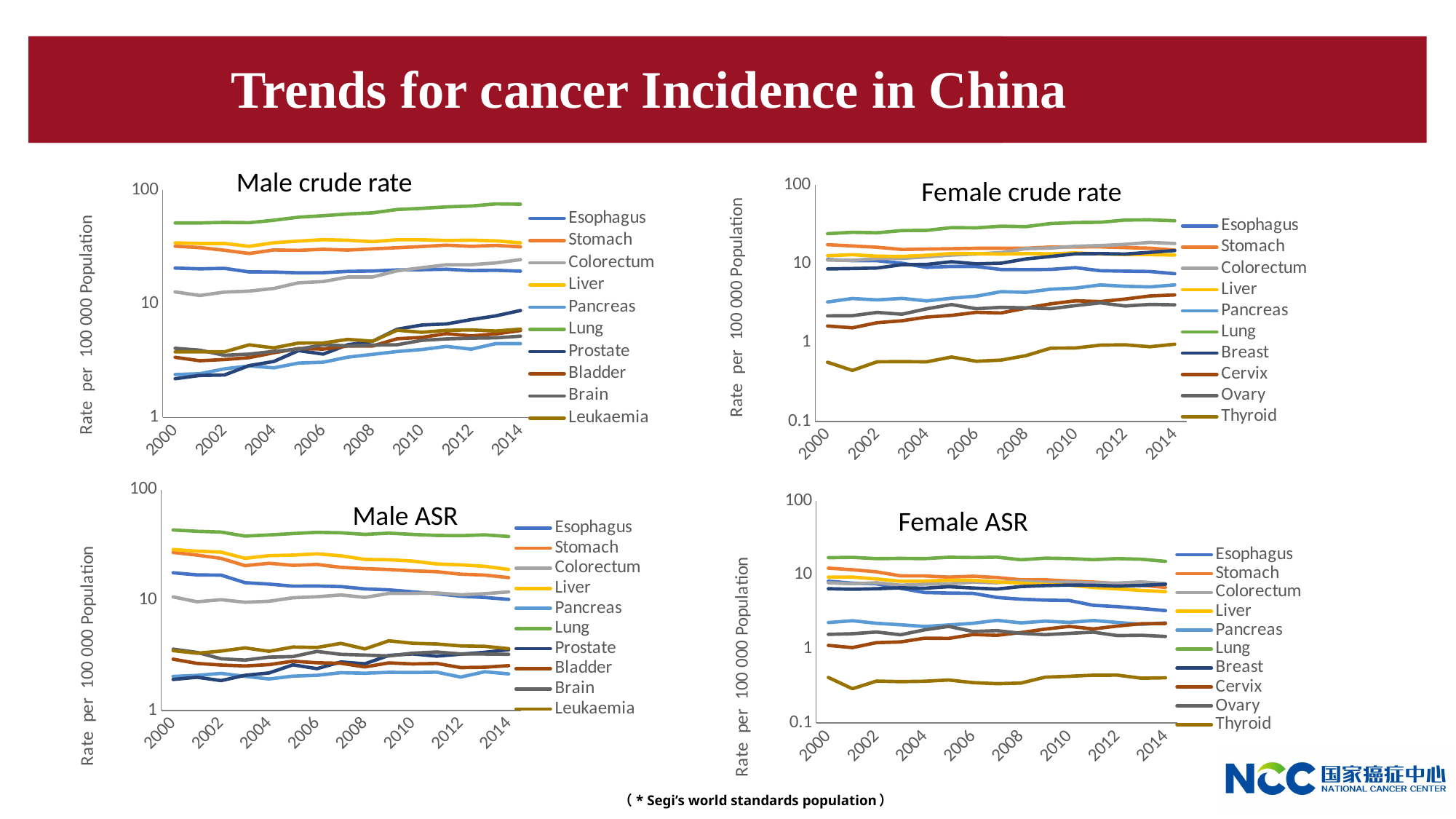
What is the y-axis label on the 'Female ASR' chart? Rate per 100 000 Population In the 'Female ASR' chart, which cancer has the lowest rate across the whole period? Thyroid In the 'Male crude rate' chart, which cancer has the highest rate across the whole period? Lung In the 'Male crude rate' chart, does the Lung rate rise or fall from 2000 to 2014? rise In the 'Female crude rate' chart, which is larger in 2014, the Lung rate or the Esophagus rate? Lung In the 'Female crude rate' chart, which cancer has the lowest rate across the whole period? Thyroid How many series does the legend of the 'Female crude rate' chart list? 10 In the 'Female ASR' chart, is the value for Thyroid in 2014 greater or less than 1? less In the 'Male crude rate' chart, is the value for Lung in 2014 greater or less than 10? greater How many series does the legend of the 'Male ASR' chart list? 10 In the 'Male ASR' chart, does the Esophagus rate rise or fall from 2000 to 2014? fall What kind of chart is the 'Male crude rate' chart? line chart